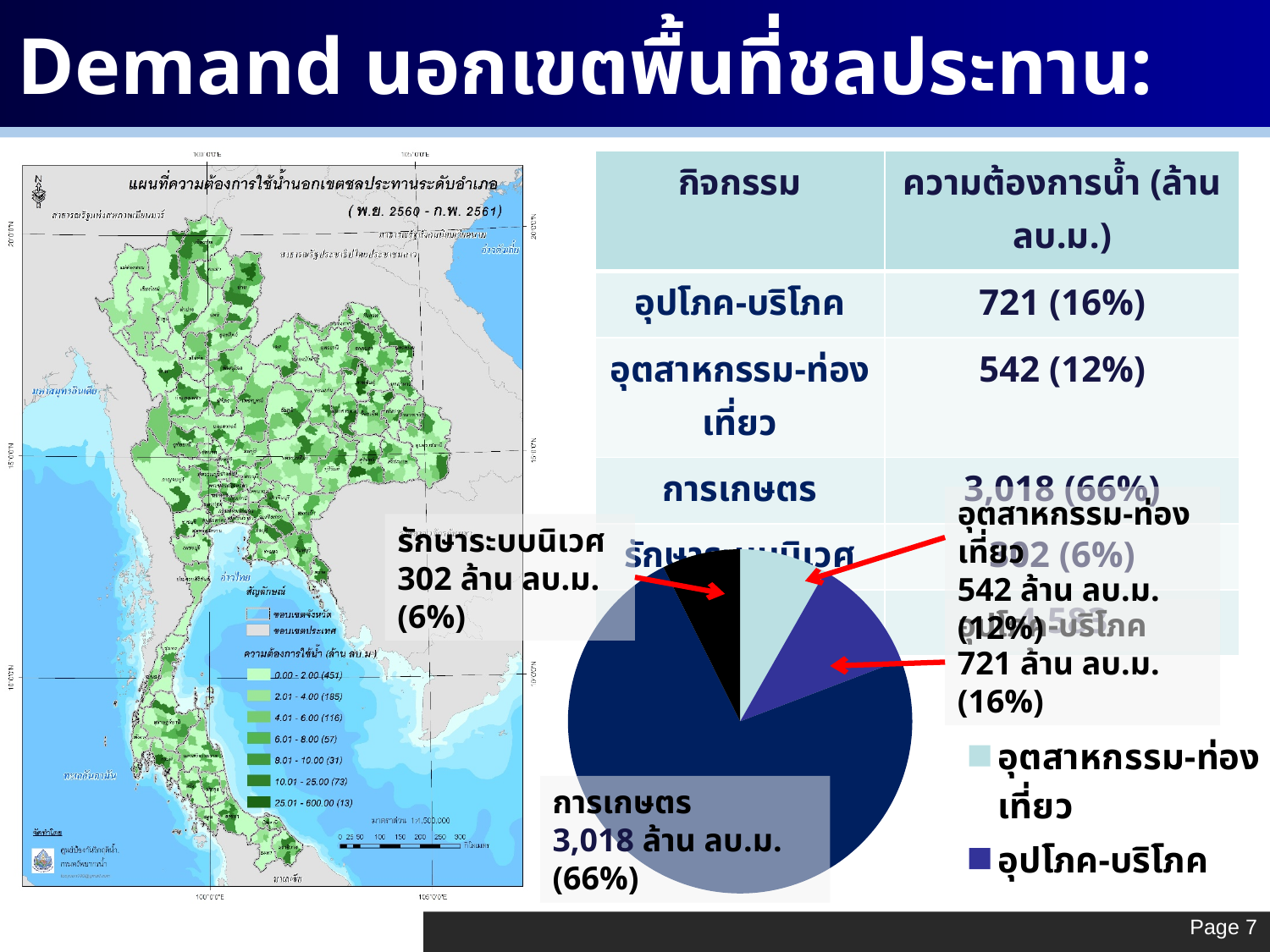
Which category has the largest slice in the pie chart? การเกษตร What colour is the การเกษตร slice in the pie chart? dark navy blue In the pie chart, what is the value for อุปโภค-บริโภค? 721 ล้าน ลบ.ม. Which category has the smallest slice in the pie chart? รักษาระบบนิเวศ How many slices does the pie chart have? 4 In the pie chart, what is the difference between the values for อุปโภค-บริโภค and อุตสาหกรรม-ท่องเที่ยว? 179 ล้าน ลบ.ม. In the pie chart, what share does การเกษตร have? 66% In the pie chart, what share does รักษาระบบนิเวศ have? 6% In the pie chart, what is the value for การเกษตร? 3,018 ล้าน ลบ.ม. In the pie chart, which is larger: อุปโภค-บริโภค or รักษาระบบนิเวศ? อุปโภค-บริโภค In the pie chart, what is the value for อุตสาหกรรม-ท่องเที่ยว? 542 ล้าน ลบ.ม. What kind of chart is shown at the bottom right of the slide? pie chart